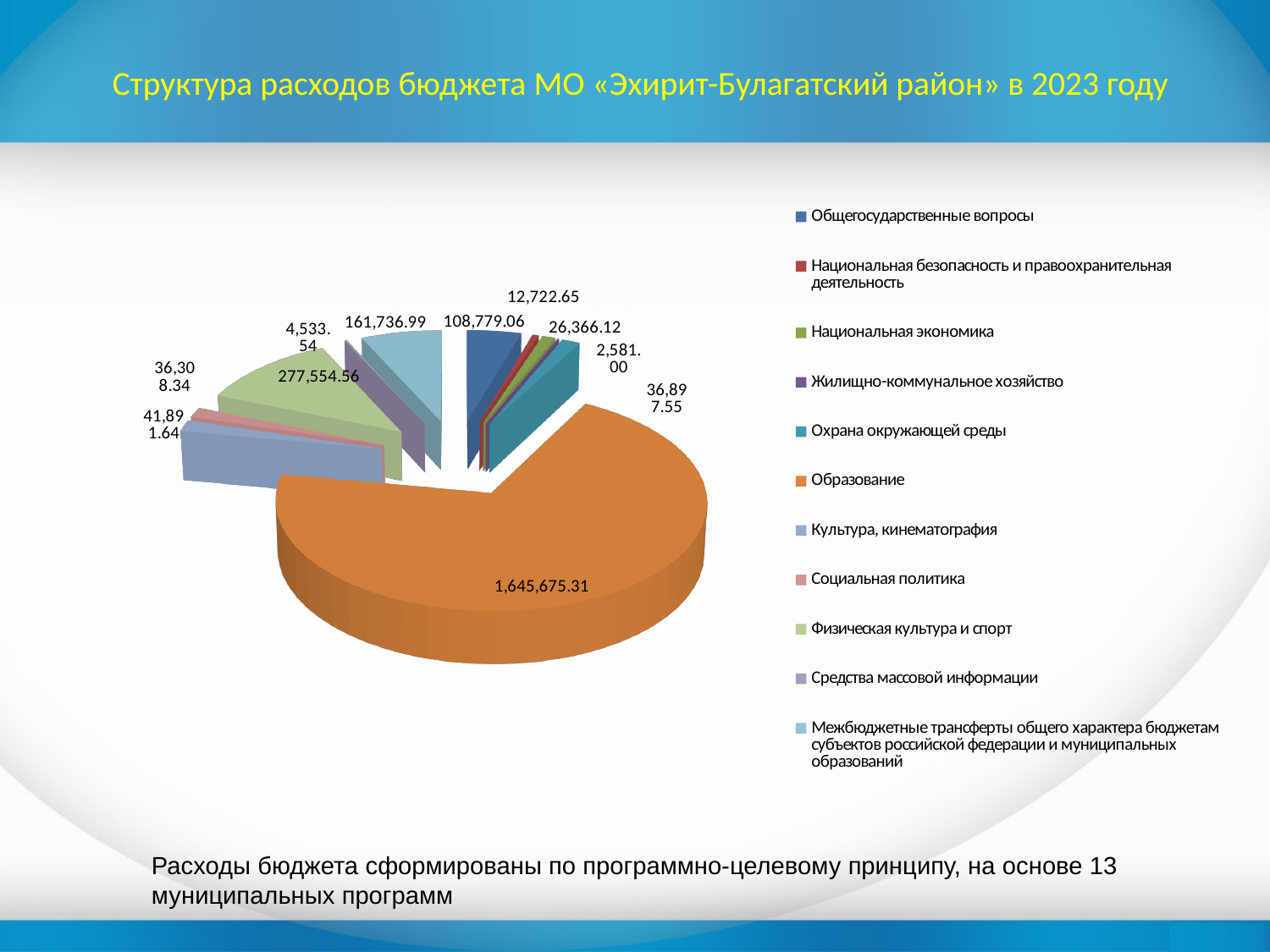
What is the value shown for Общегосударственные вопросы? 108,779.06 What is the value shown for Образование? 1,645,675.31 Which is larger: the value for Образование or the value for Физическая культура и спорт? Образование How many categories does the legend of the pie chart list? 11 Which category has the largest slice in the pie chart? Образование What is the value shown for Межбюджетные трансферты общего характера бюджетам субъектов российской федерации и муниципальных образований? 161,736.99 What is the difference between the values for Образование and Физическая культура и спорт? 1,368,120.75 What is the title of the slide containing the pie chart? Структура расходов бюджета МО «Эхирит-Булагатский район» в 2023 году Which category has the smallest slice in the pie chart? Жилищно-коммунальное хозяйство What kind of chart is shown on the slide? Pie chart What is the value shown for Физическая культура и спорт? 277,554.56 Which is larger: the value for Межбюджетные трансферты общего характера бюджетам субъектов российской федерации и муниципальных образований or the value for Общегосударственные вопросы? Межбюджетные трансферты общего характера бюджетам субъектов российской федерации и муниципальных образований